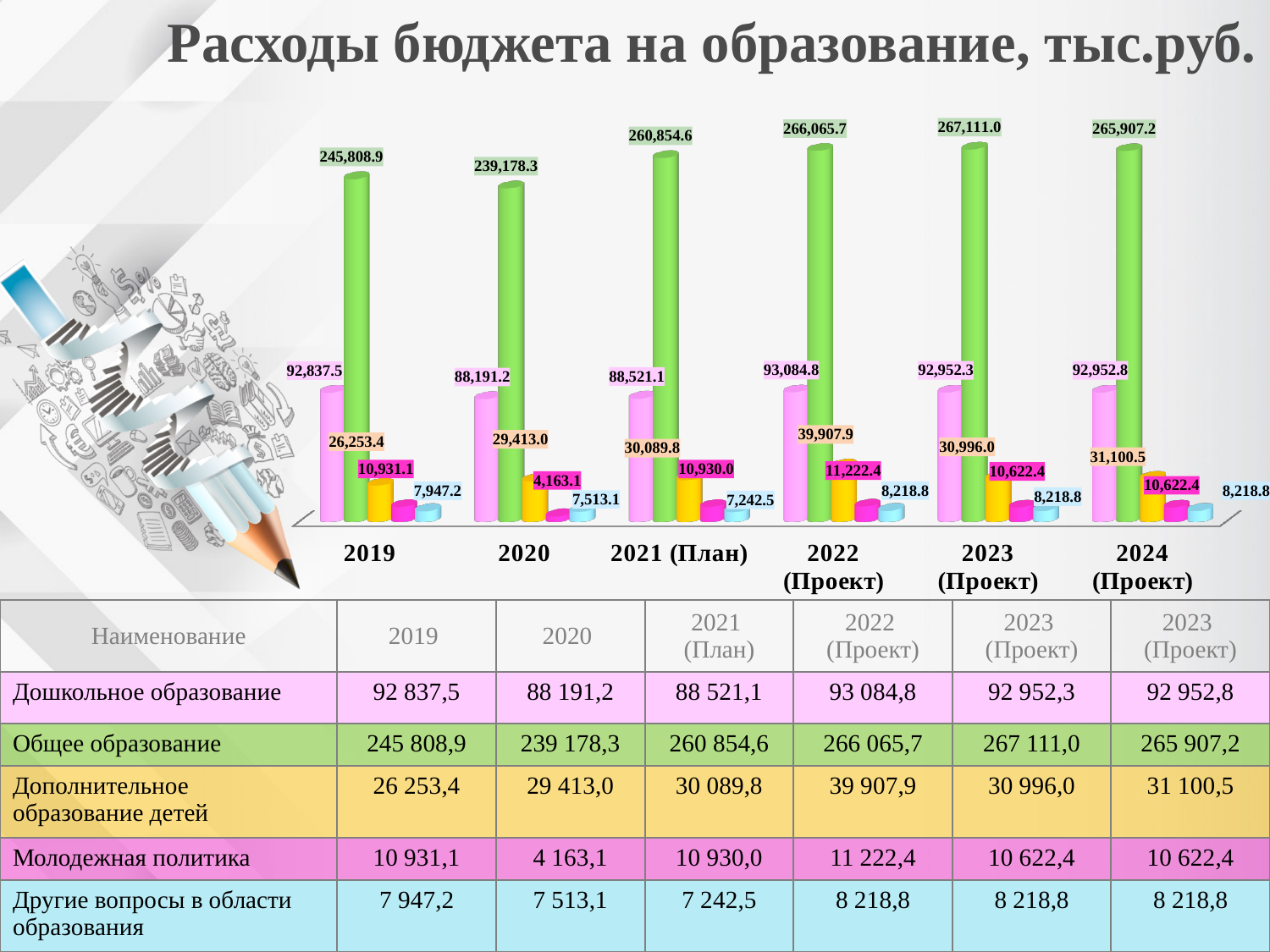
In which year is the green bar (Общее образование) the highest? 2023 (Проект) What type of chart is shown on the slide? bar chart By how much does the green bar (Общее образование) for 2021 (План) exceed the one for 2020? 21,676.3 Do the light blue bars (Другие вопросы в области образования) rise or fall from 2019 to 2021 (План)? fall What is the value of the light blue bar (Другие вопросы в области образования) for 2024 (Проект)? 8,218.8 In which year is the magenta bar (Молодежная политика) the lowest? 2020 What is the value of the pink bar (Дошкольное образование) for 2022 (Проект)? 93,084.8 How many series (bars) are plotted for each year in the chart? 5 How many years (categories) are shown on the x axis of the chart? 6 What is the difference between the pink bar (Дошкольное образование) values for 2019 and 2020? 4,646.3 Which is larger: the yellow bar (Дополнительное образование детей) for 2022 (Проект) or for 2023 (Проект)? 2022 (Проект) What is the value of the green bar (Общее образование) for 2019? 245,808.9